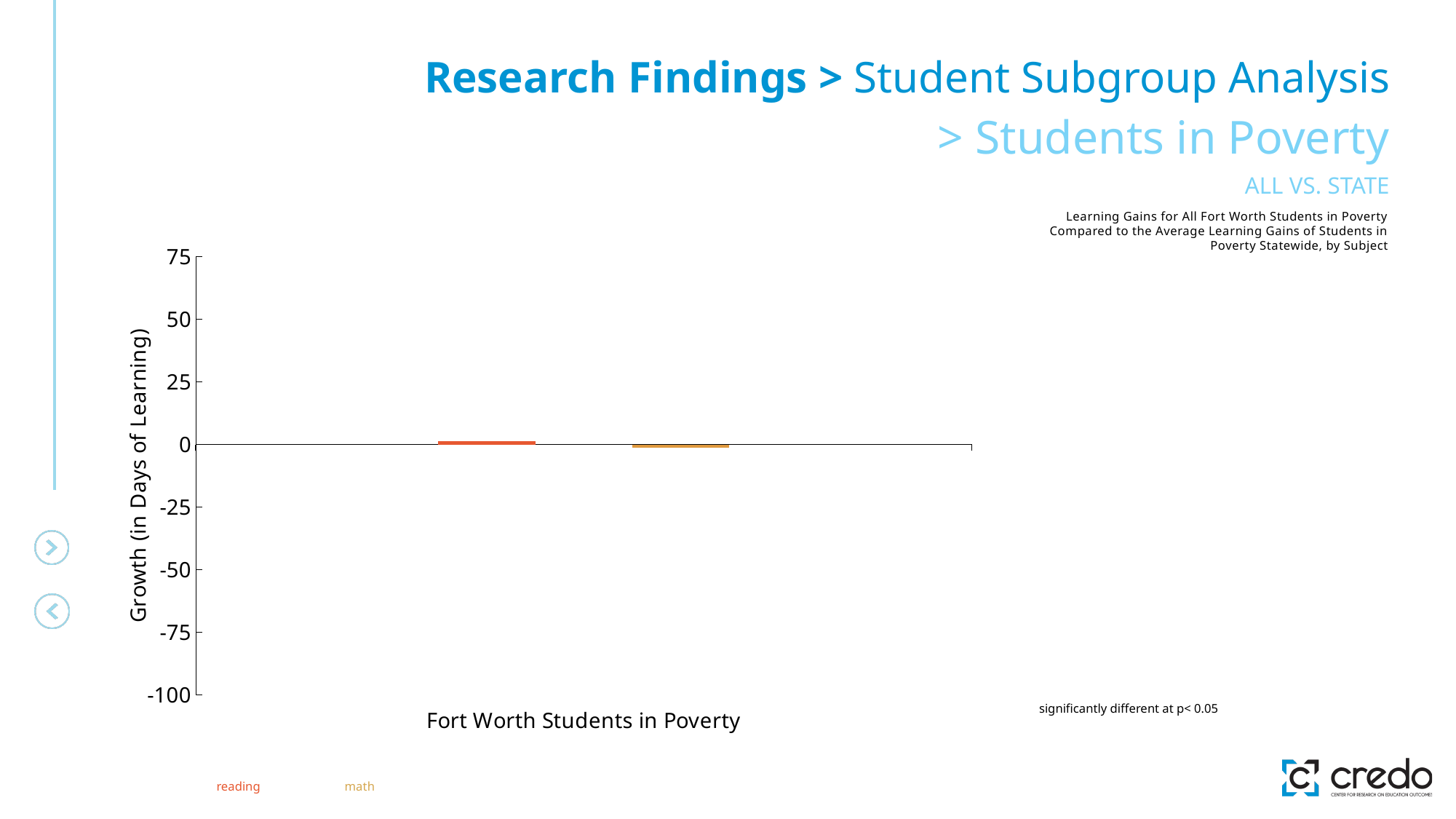
Is the value for reading greater or less than -50? greater Is the value for math greater or less than 50? less How many categories are shown on the x axis? 1 How many series does the legend list? 2 What is the highest value shown on the y axis? 75 What is the category label on the x axis? Fort Worth Students in Poverty Is the value for math greater or less than -25? greater Which series are listed in the legend? reading and math What kind of chart is shown on the slide? bar chart